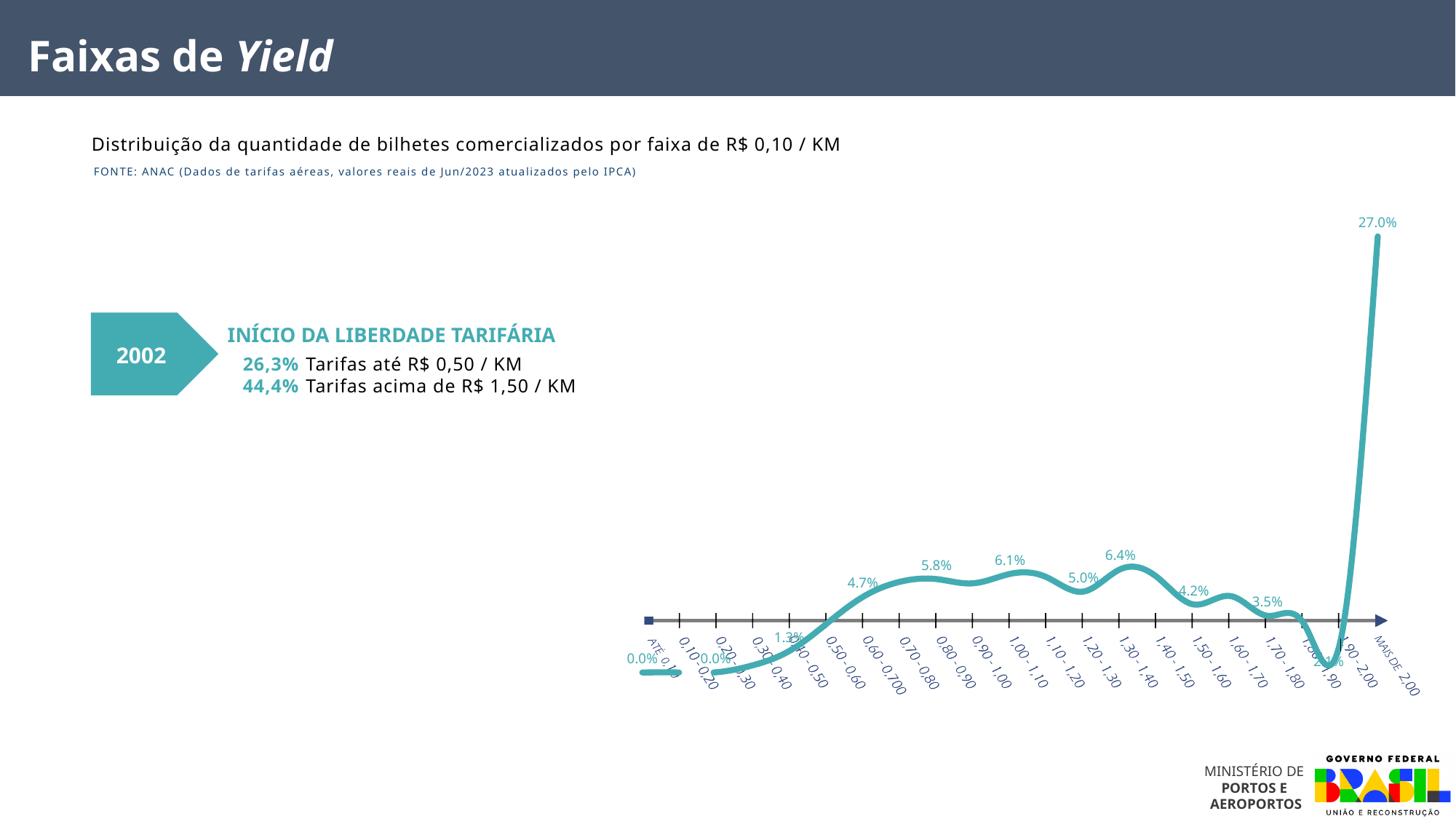
Between the point labelled 6.4% and the point labelled 3.5%, does the line rise or fall? fall How many categories are shown along the x axis of the chart? 21 What is the value shown for the category ATÉ 0,10? 0.0% What is the subtitle describing the chart's data? Distribuição da quantidade de bilhetes comercializados por faixa de R$ 0,10 / KM Which is larger, the value for MAIS DE 2,00 or the value for ATÉ 0,10? MAIS DE 2,00 What source is cited for the chart data? ANAC What kind of chart is shown on the slide? line chart What is the highest data label shown among the categories below MAIS DE 2,00? 6.4% What is the value shown for the category MAIS DE 2,00? 27.0% Which category has the highest value in the chart? MAIS DE 2,00 What is the difference between the 27.0% data label and the 6.4% data label? 20.6 percentage points